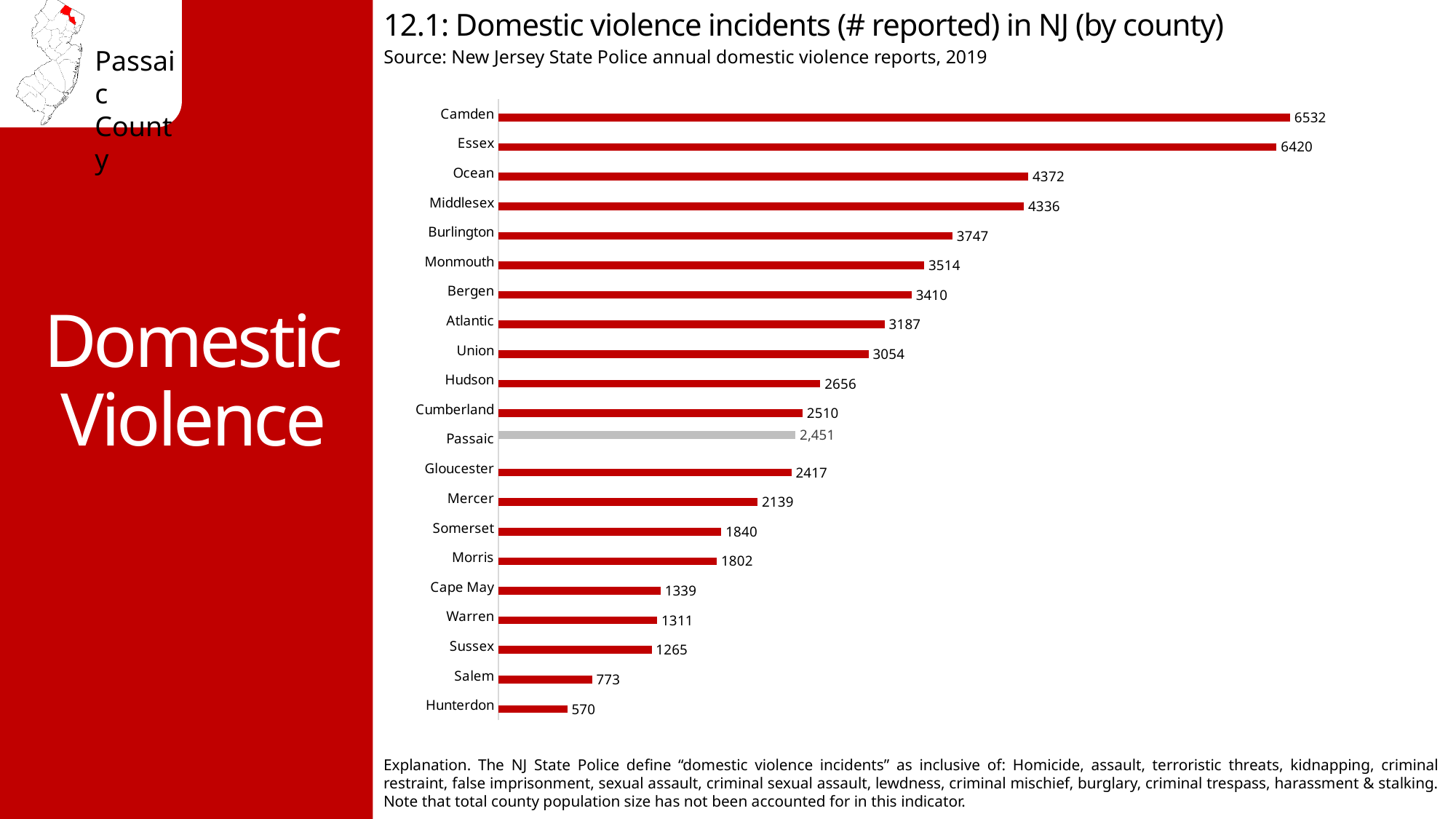
Which county has more reported incidents, Salem or Sussex? Sussex Which county has more reported incidents, Monmouth or Bergen? Monmouth What is the difference between the values for Passaic and Gloucester? 34 Which county has the highest number of reported domestic violence incidents? Camden How many domestic violence incidents were reported in Passaic County? 2,451 Which county's bar is shown in grey rather than red? Passaic Which county has the lowest number of reported domestic violence incidents? Hunterdon What type of chart is used to show domestic violence incidents by county? Bar chart What is the number of reported domestic violence incidents for Bergen County? 3410 What is the difference between the values for Camden and Essex? 112 How many counties are shown in the chart? 21 What value is shown for Hunterdon County? 570